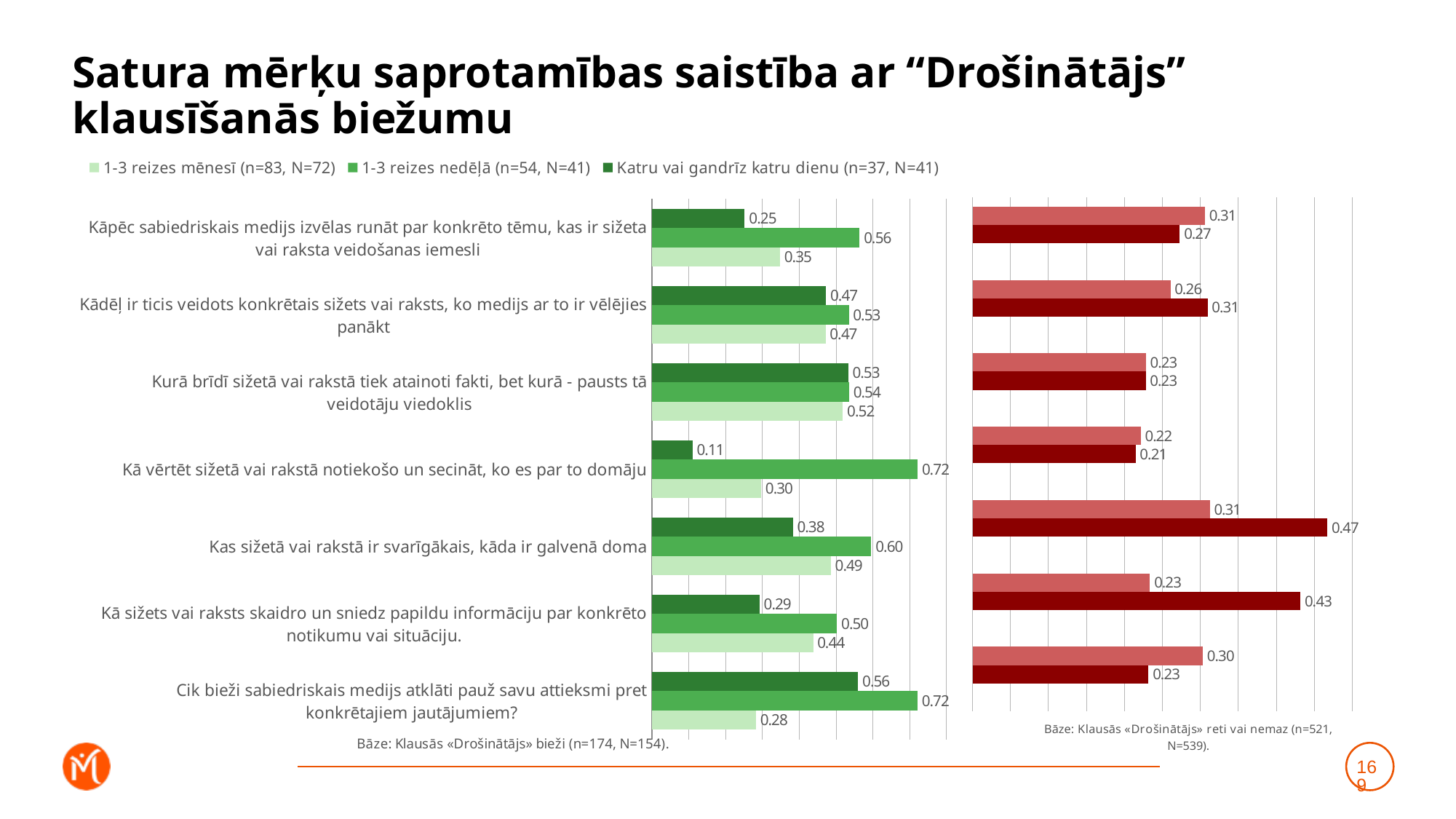
How many categories are shown in the left (green) chart? 7 What base note is printed below the left (green) chart? Bāze: Klausās «Drošinātājs» bieži (n=174, N=154). In the left (green) chart, what is the value for "Kāpēc sabiedriskais medijs izvēlas runāt par konkrēto tēmu, kas ir sižeta vai raksta veidošanas iemesli" in the "Katru vai gandrīz katru dienu" series? 0.25 In the left (green) chart, what is the value for "Kā sižets vai raksts skaidro un sniedz papildu informāciju par konkrēto notikumu vai situāciju." in the "1-3 reizes mēnesī" series? 0.44 In the left (green) chart, what is the value for "Kā vērtēt sižetā vai rakstā notiekošo un secināt, ko es par to domāju" in the "1-3 reizes nedēļā" series? 0.72 In the left (green) chart, what is the difference between the "1-3 reizes nedēļā" and "1-3 reizes mēnesī" values for "Cik bieži sabiedriskais medijs atklāti pauž savu attieksmi pret konkrētajiem jautājumiem?"? 0.44 In the left (green) chart, which category has the lowest value in the "Katru vai gandrīz katru dienu" series? Kā vērtēt sižetā vai rakstā notiekošo un secināt, ko es par to domāju What is the highest value shown in the right (red) chart? 0.47 In the left (green) chart, for "Kas sižetā vai rakstā ir svarīgākais, kāda ir galvenā doma", which series has the larger value: "1-3 reizes nedēļā" or "Katru vai gandrīz katru dienu"? 1-3 reizes nedēļā How many series does the legend of the left (green) chart list? 3 What type of chart is the left (green) chart? Bar chart In the left (green) chart, which category has the highest value in the "1-3 reizes mēnesī" series? Kurā brīdī sižetā vai rakstā tiek atainoti fakti, bet kurā - pausts tā veidotāju viedoklis